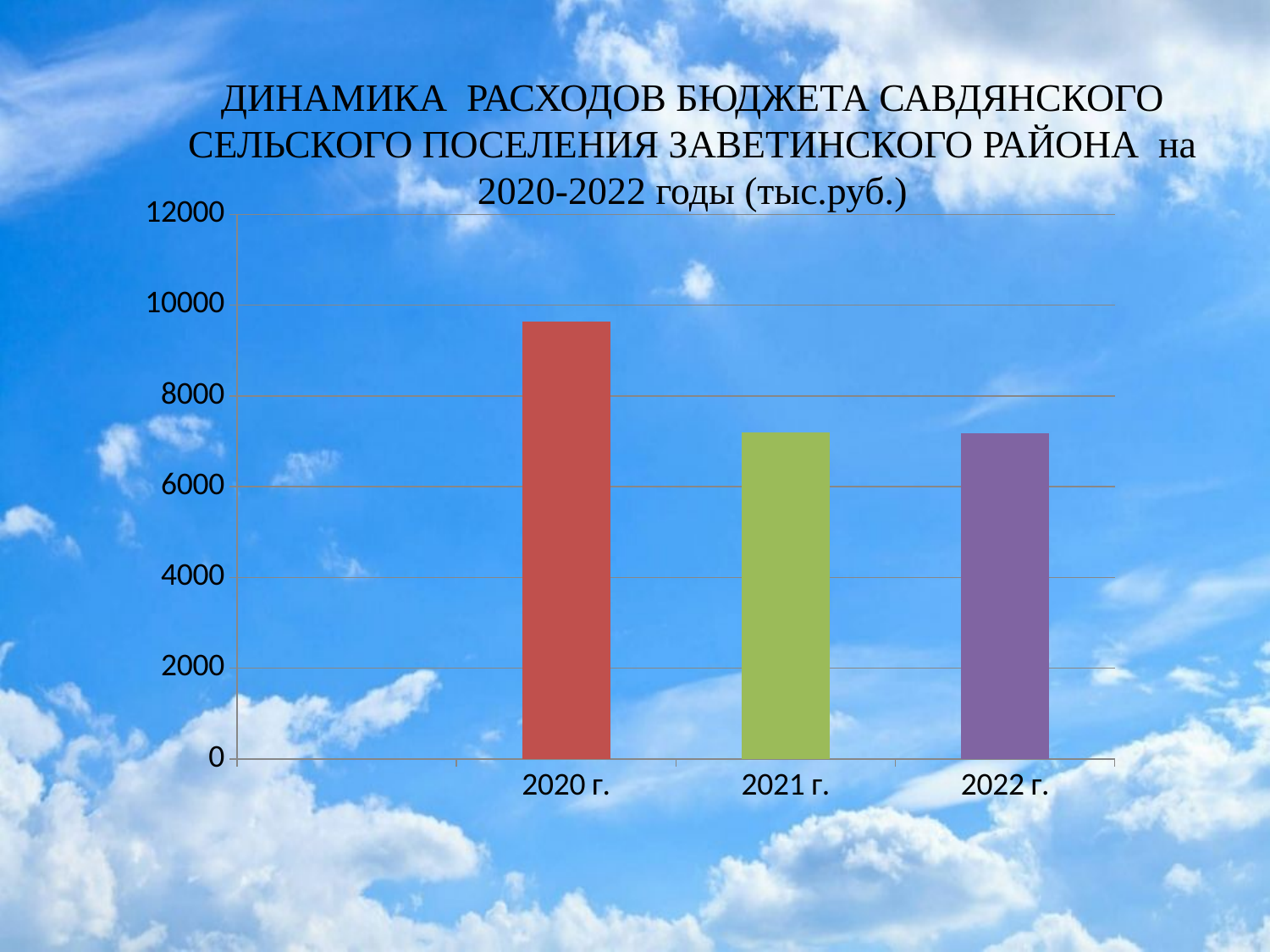
Is the value for 2022 г. greater or less than 8000? less How many bars (years) are plotted in the chart? 3 Which year has the highest budget expenditure in the chart? 2020 г. Is the value for 2021 г. greater or less than 6000? greater Is the value for 2020 г. greater or less than 10000? less In what units are the values in the chart expressed, according to the title? тыс.руб. Does the value rise or fall from 2020 г. to 2021 г.? fall Which is larger, the value for 2020 г. or the value for 2022 г.? 2020 г. What kind of chart is shown on the slide? Bar chart